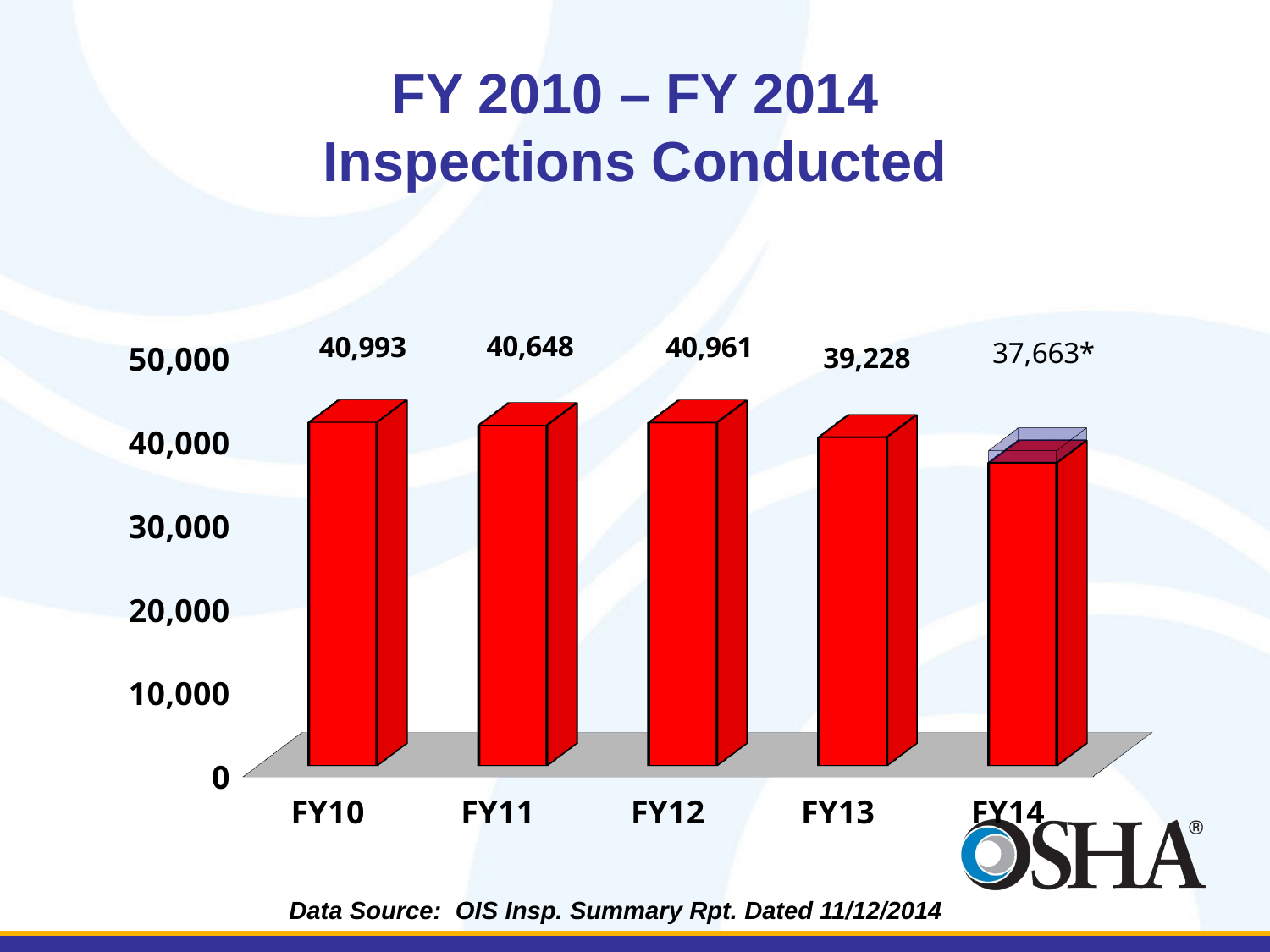
What is the number of inspections conducted in FY13? 39,228 Which is larger, the value for FY11 or the value for FY12? FY12 What kind of chart is shown on the slide? bar chart Is the value for FY14 greater or less than 40,000? less Which fiscal year has the lowest number of inspections conducted? FY14 What is the number of inspections conducted in FY10? 40,993 What is the difference between the inspections conducted in FY13 and FY14? 1,565 What is the difference between the inspections conducted in FY10 and FY14? 3,330 How many fiscal years are shown on the chart? 5 Do the inspection counts generally rise or fall from FY10 to FY14? fall What value is labelled for FY14? 37,663* Which fiscal year has the highest number of inspections conducted? FY10